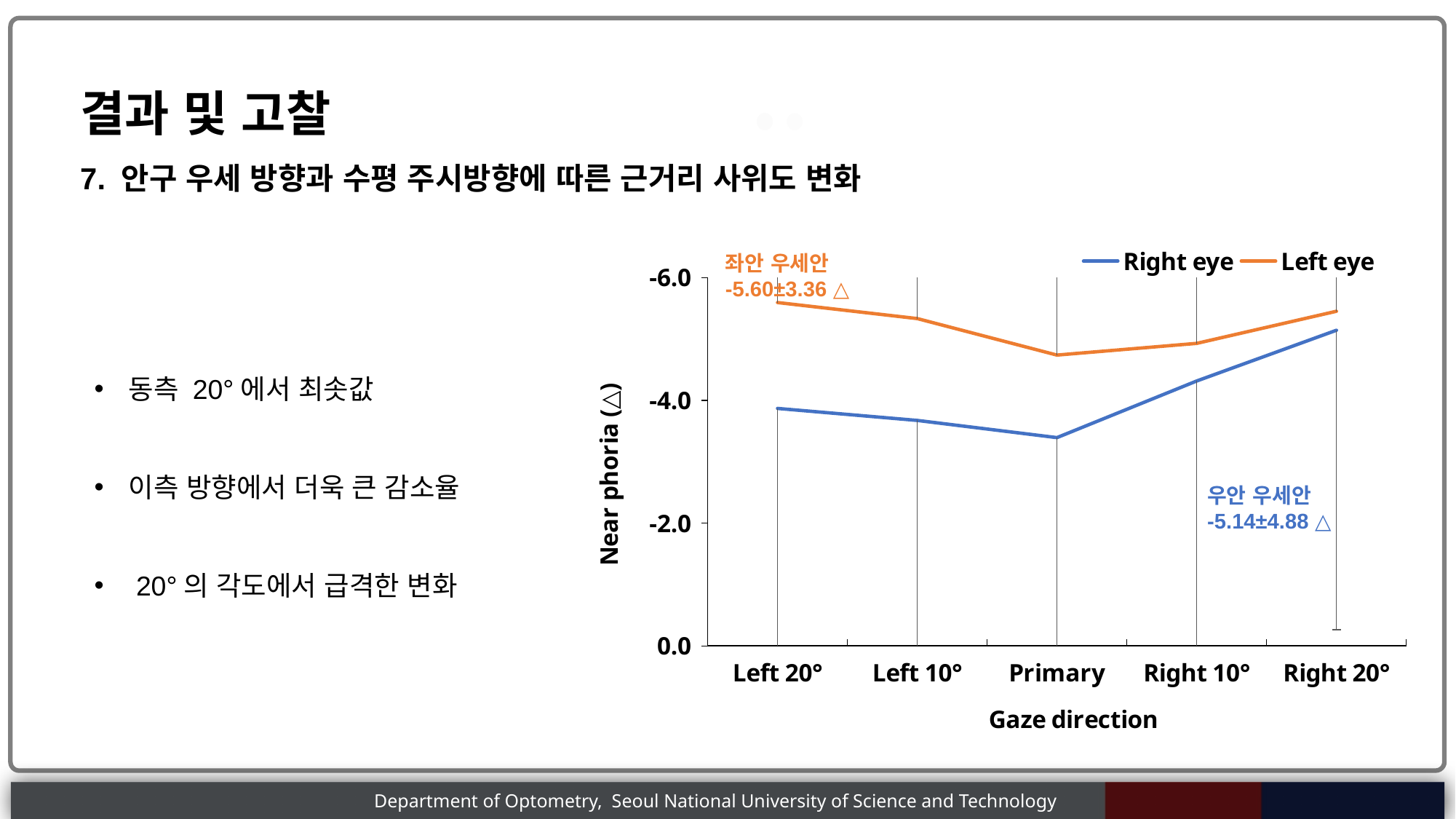
For the Right eye series, at which gaze direction is the near phoria closest to zero? Primary Which series is drawn in orange in the chart? Left eye What is the title of the y axis of the chart? Near phoria (△) How many gaze directions are shown on the x axis of the chart? 5 For the Right eye series, at which gaze direction is the near phoria most negative? Right 20° What value is annotated for 우안 우세안 on the chart? -5.14±4.88 △ How many series does the chart legend list? 2 For the Left eye series, at which gaze direction is the near phoria most negative? Left 20° Moving from Primary to Right 20°, does the Right eye near phoria become more negative or less negative? more negative What value is annotated for 좌안 우세안 on the chart? -5.60±3.36 △ At the Primary gaze direction, which series has the more negative near phoria value? Left eye What kind of chart is shown on the slide? line chart